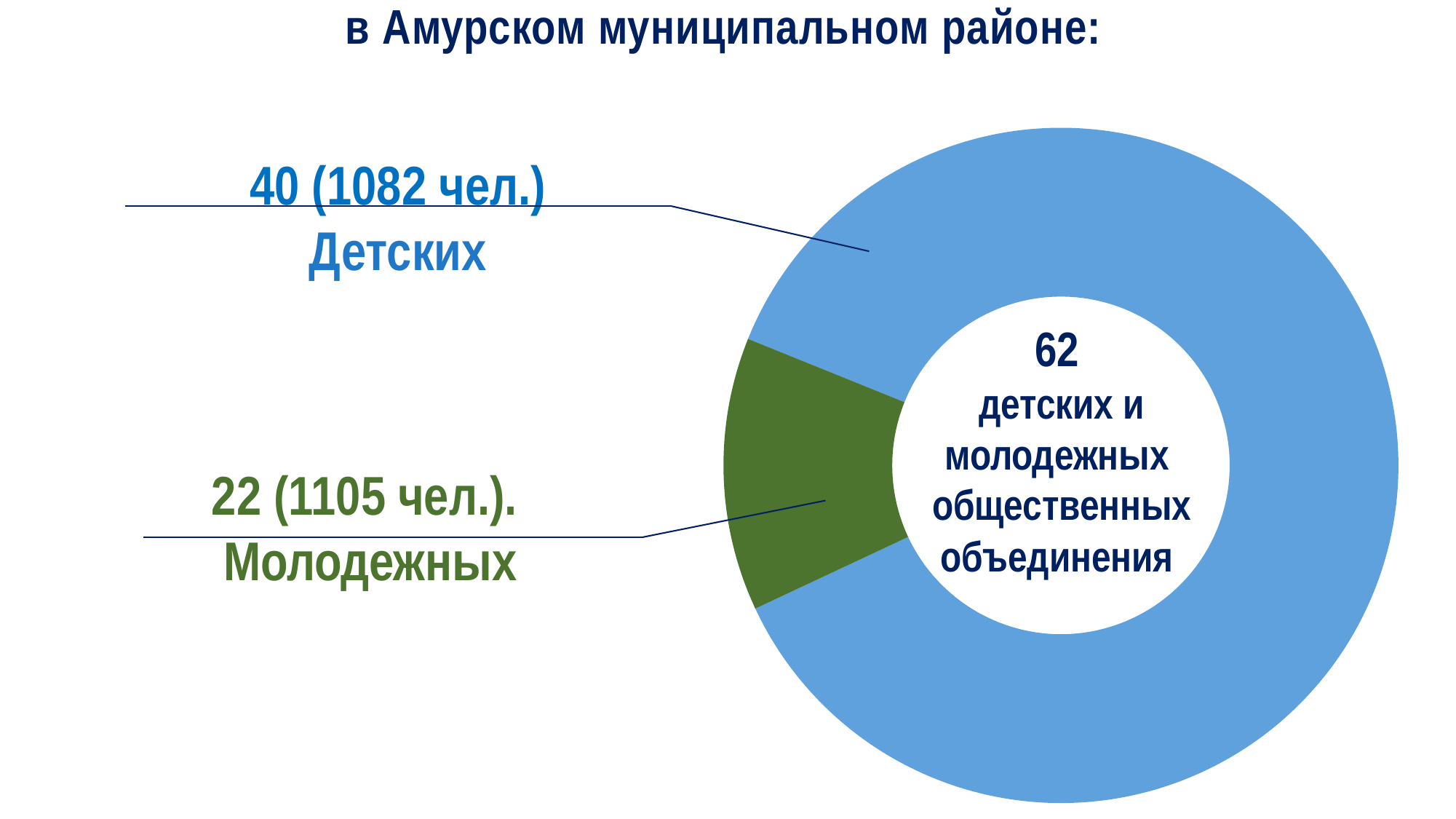
How many people are in the Детских associations according to the chart label? 1082 чел. What colour is the slice for Детских associations? blue Which category has more people, Детских or Молодежных? Молодежных How many Молодежных (youth) associations are shown on the chart? 22 Which category has the larger number of associations, Детских or Молодежных? Детских How many categories (slices) does the chart have? 2 What is the difference between the number of Детских and Молодежных associations? 18 What is the difference in the number of people between Молодежных (1105 чел.) and Детских (1082 чел.)? 23 How many people are in the Молодежных associations according to the chart label? 1105 чел. What is the total number of children's and youth public associations shown in the centre of the chart? 62 How many Детских (children's) associations are shown on the chart? 40 What kind of chart is shown on the slide? doughnut (pie) chart